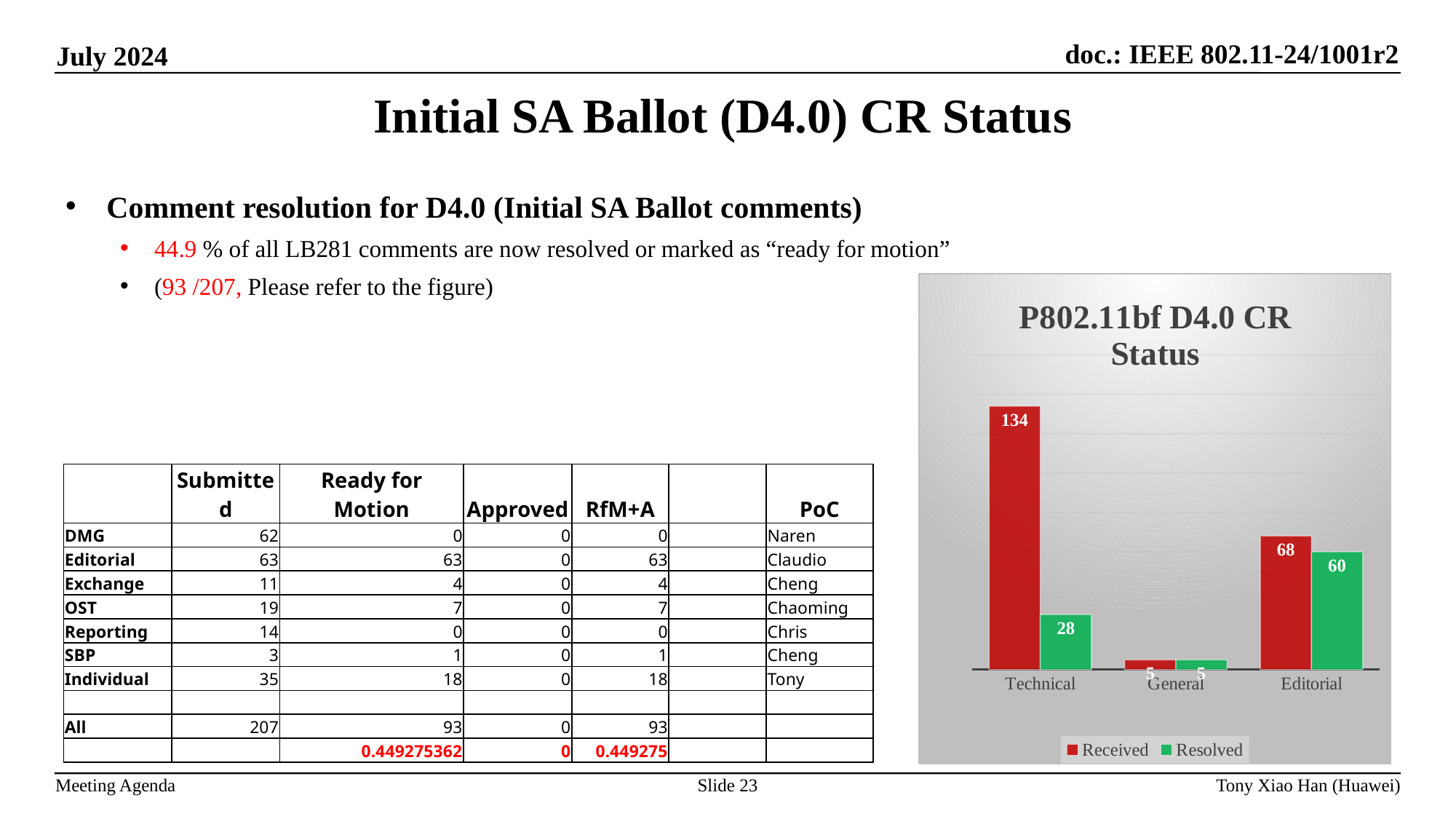
How many series does the legend list? 2 Which is larger, the Resolved value for Editorial or the Resolved value for Technical? Editorial What is the Resolved value for Technical? 28 What type of chart is shown? Bar chart What is the Resolved value for Editorial? 60 What is the Received value for Editorial? 68 What is the Received value for Technical? 134 Which category has the lowest Resolved value? General What is the difference between Received and Resolved for Technical? 106 What is the difference between Received and Resolved for Editorial? 8 Which category has the highest Received value? Technical How many categories are shown on the x axis? 3